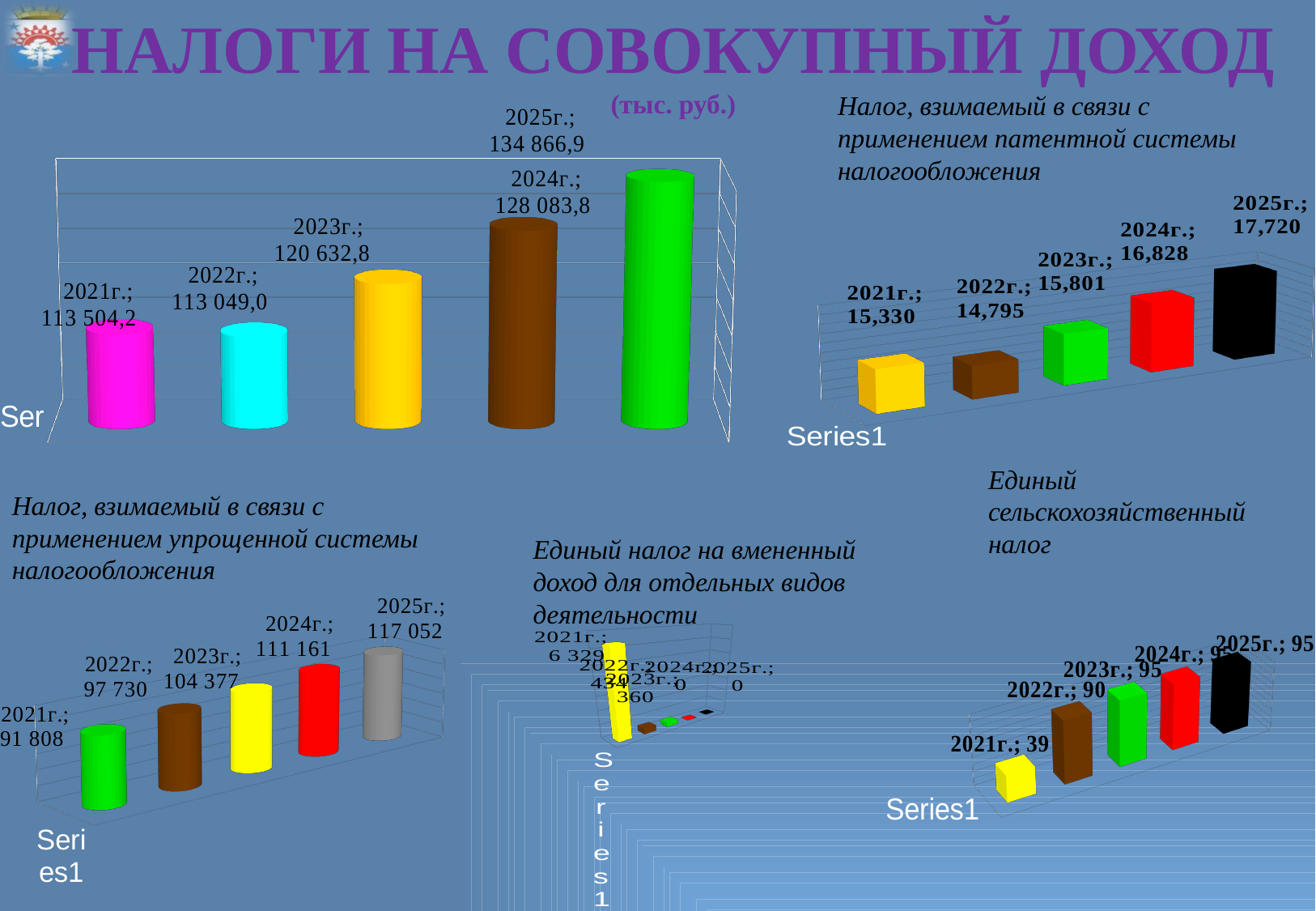
In the chart 'Единый сельскохозяйственный налог', what is the value for 2021г.? 39 In the top-left chart (тыс. руб.), which year has the lowest value? 2022г. In the chart 'Налог, взимаемый в связи с применением патентной системы налогообложения', which is larger, the value for 2021г. or 2022г.? 2021г. In the top-left chart (тыс. руб.), what is the value for 2025г.? 134 866,9 In the top-left chart (тыс. руб.), what is the difference between the 2025г. and 2024г. values? 6 783,1 In the chart 'Налог, взимаемый в связи с применением патентной системы налогообложения', what is the value for 2023г.? 15,801 In the chart 'Единый налог на вмененный доход для отдельных видов деятельности', what is the value for 2025г.? 0 In the chart 'Налог, взимаемый в связи с применением упрощенной системы налогообложения', do the values rise or fall from 2021г. to 2025г.? rise In the chart 'Налог, взимаемый в связи с применением упрощенной системы налогообложения', what is the value for 2021г.? 91 808 In the chart 'Налог, взимаемый в связи с применением патентной системы налогообложения', which year has the highest value? 2025г. What kind of chart is the top-left chart (тыс. руб.)? bar chart In the top-left chart (тыс. руб.), how many years are plotted? 5